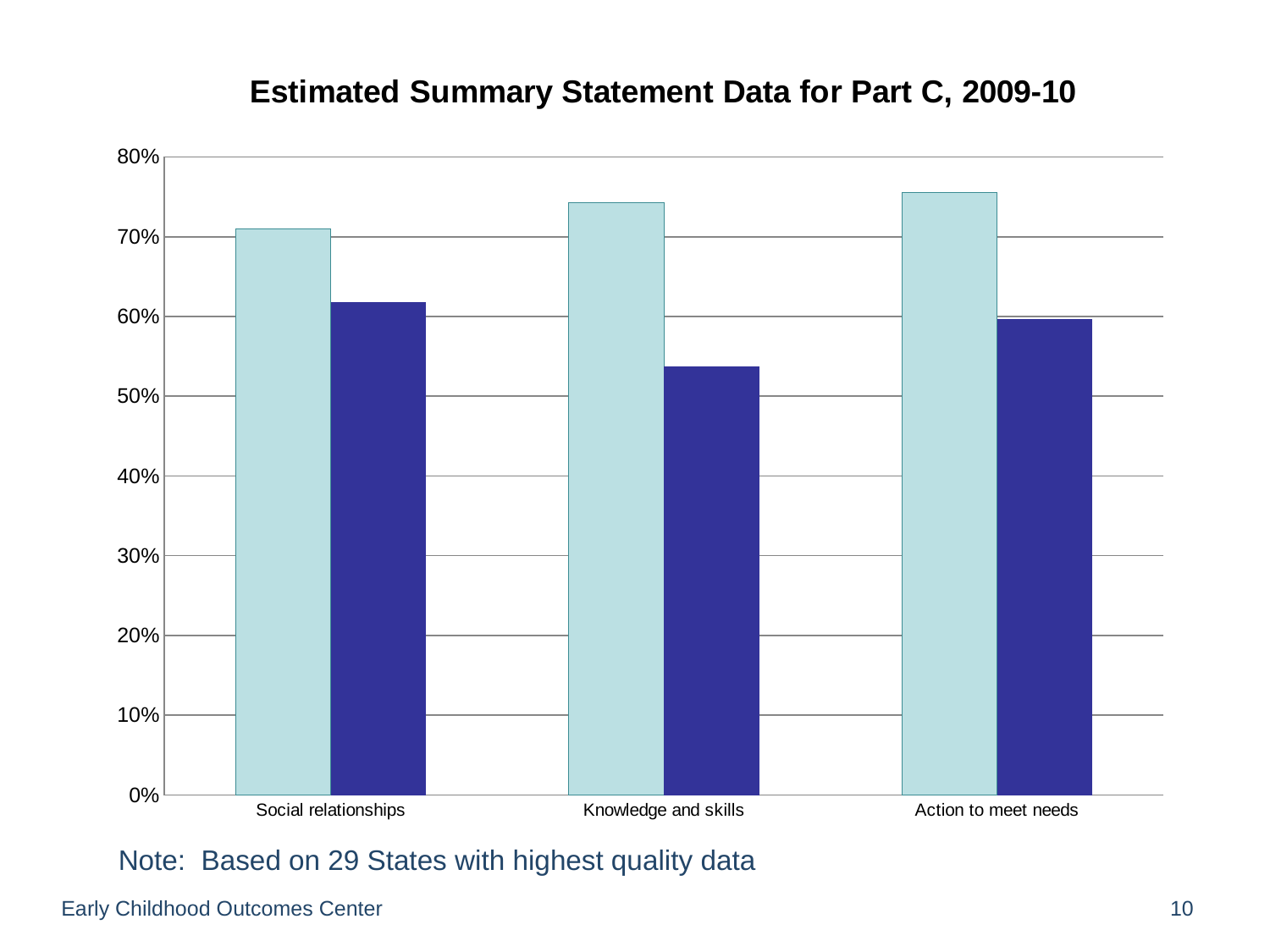
What is the title of the chart? Estimated Summary Statement Data for Part C, 2009-10 For Knowledge and skills, which bar is taller, the light blue or the dark blue? light blue Is the dark blue bar for Social relationships greater or less than 50%? greater Is the dark blue bar for Action to meet needs greater or less than 50%? greater According to the note below the chart, how many States is the data based on? 29 States Is the light blue bar for Action to meet needs greater or less than 70%? greater What kind of chart is shown on the slide? bar chart How many categories are shown on the x axis? 3 Which category has the lowest dark blue bar? Knowledge and skills How many bars are shown for each category? 2